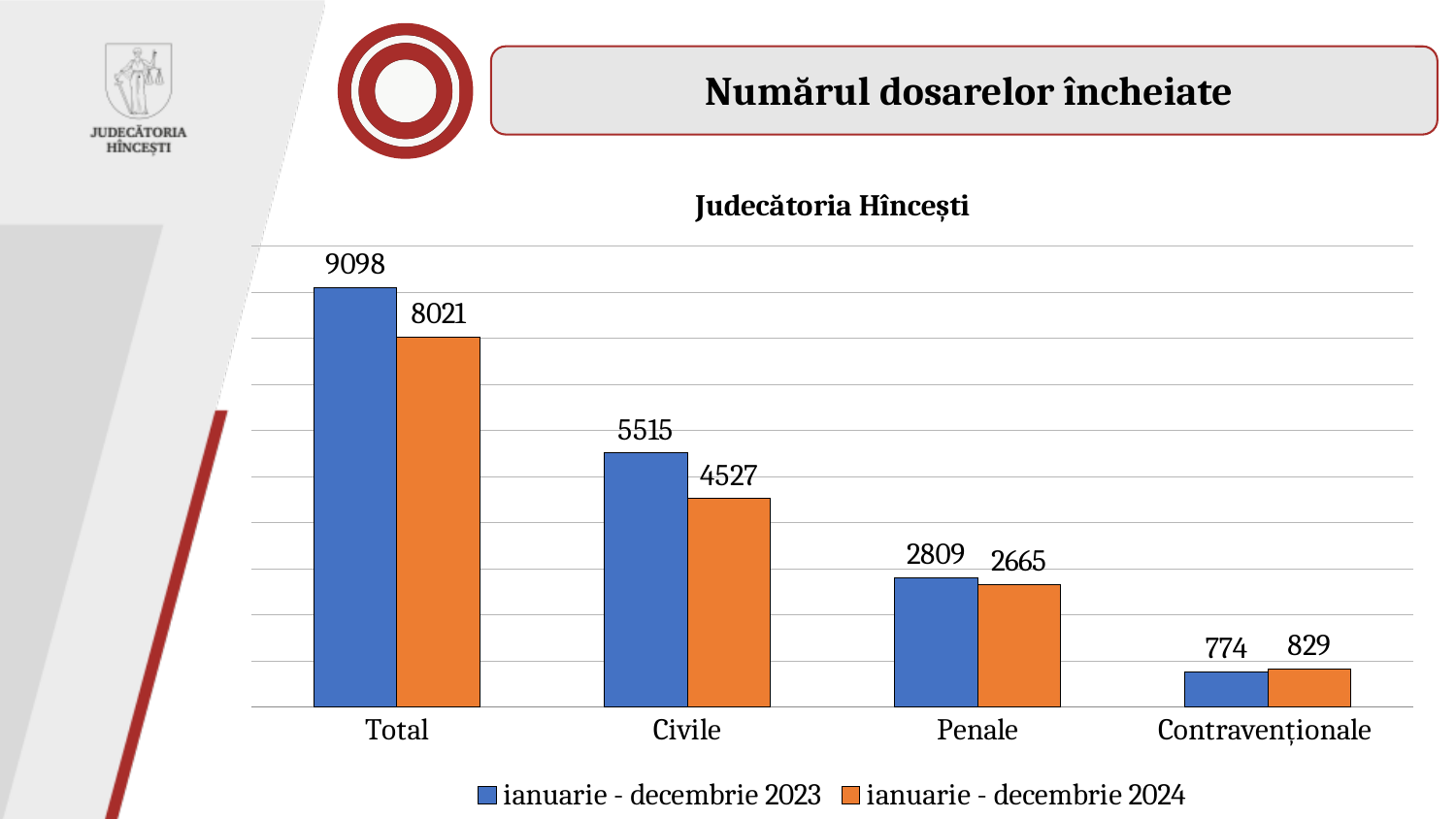
Which category has the highest value in the ianuarie - decembrie 2023 series? Total What is the difference between the Total values for ianuarie - decembrie 2023 and ianuarie - decembrie 2024? 1077 What is the difference between the Civile values for ianuarie - decembrie 2023 and ianuarie - decembrie 2024? 988 How many series does the legend list? 2 Which category has the lowest value in the ianuarie - decembrie 2024 series? Contravenționale How many categories are shown on the x axis? 4 What is the value for Penale in the ianuarie - decembrie 2024 series? 2665 What is the value for Civile in the ianuarie - decembrie 2023 series? 5515 For Contravenționale, which series has the larger value: ianuarie - decembrie 2023 or ianuarie - decembrie 2024? ianuarie - decembrie 2024 What kind of chart is shown on the slide? Bar chart What is the title of the chart? Judecătoria Hîncești What is the value for Contravenționale in the ianuarie - decembrie 2024 series? 829